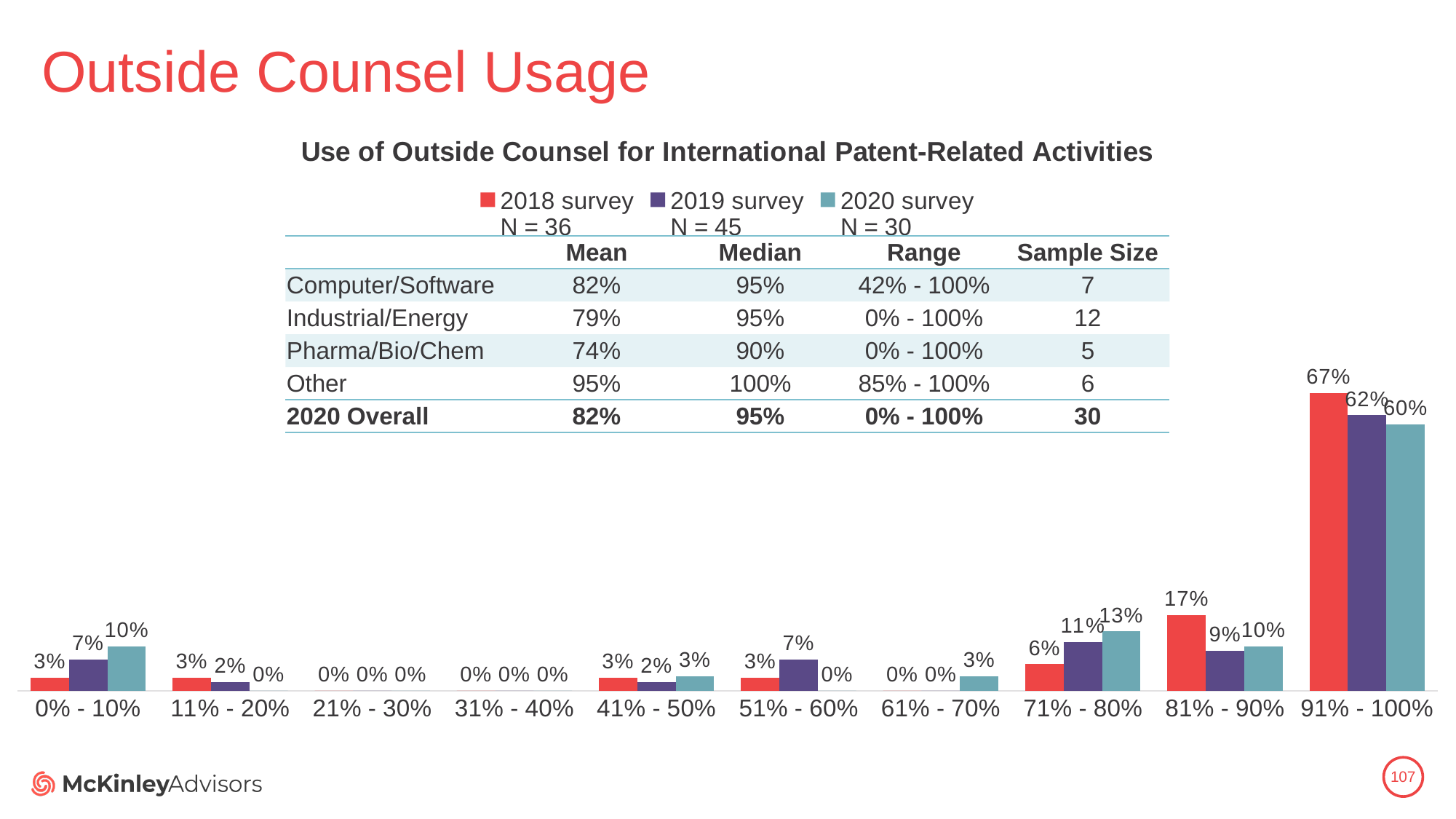
What is the 2020 survey value for the 61% - 70% category? 3% Which is larger for the 0% - 10% category: the 2019 survey value or the 2020 survey value? 2020 survey How many series does the chart legend list? 3 Which category has the highest 2018 survey value? 91% - 100% What is the sample size (N) for the 2019 survey shown in the legend? N = 45 What is the 2020 survey value for the 91% - 100% category? 60% What is the 2018 survey value for the 81% - 90% category? 17% What is the 2019 survey value for the 71% - 80% category? 11% What is the difference between the 2018 survey and 2019 survey values for the 81% - 90% category? 8% What is the difference between the 2018 survey and 2020 survey values for the 91% - 100% category? 7% What type of chart is shown on the slide? bar chart How many categories are shown along the x axis of the chart? 10